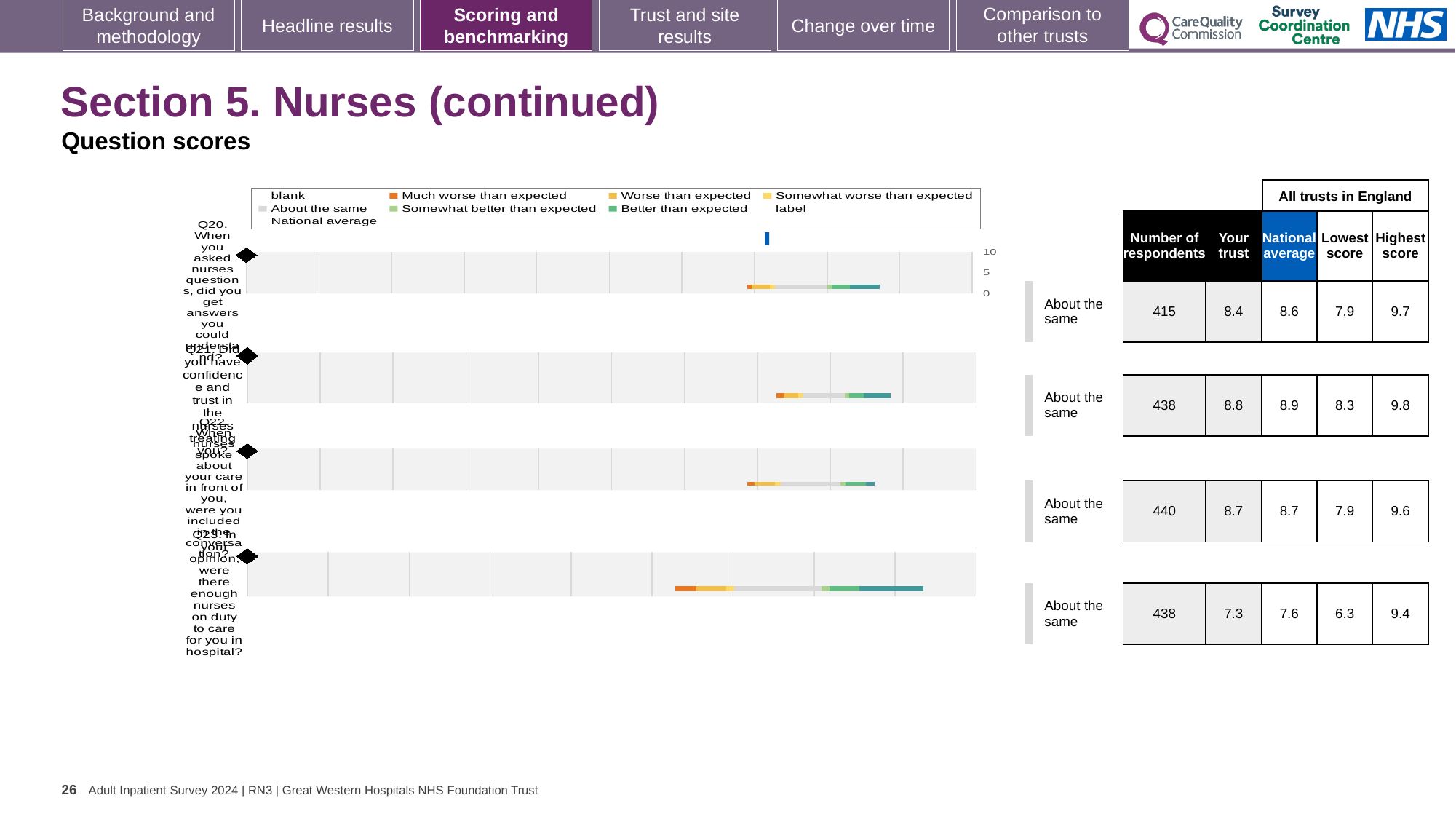
For Q23, what is the difference between the highest score (9.4) and the lowest score (6.3) in the table beside the chart? 3.1 In the table beside the chart, what is the 'Your trust' score for Q20 (When you asked nurses questions, did you get answers you could understand)? 8.4 How many questions (rows) are plotted in the chart? 4 In the table beside the chart, what is the national average for Q23 (were there enough nurses on duty to care for you in hospital)? 7.6 What is the highest value shown on the chart's score axis? 10 Which question has the lowest 'Your trust' score in the table beside the chart? Q23 Which question has the highest 'Your trust' score in the table beside the chart? Q21 How many entries does the chart legend list? 9 What benchmark category is shown for all four questions on the chart? About the same What kind of chart is shown on the slide? Bar chart In the table beside the chart, how many respondents answered Q22? 440 For Q20, which is larger in the table beside the chart: the 'Your trust' score or the national average? National average